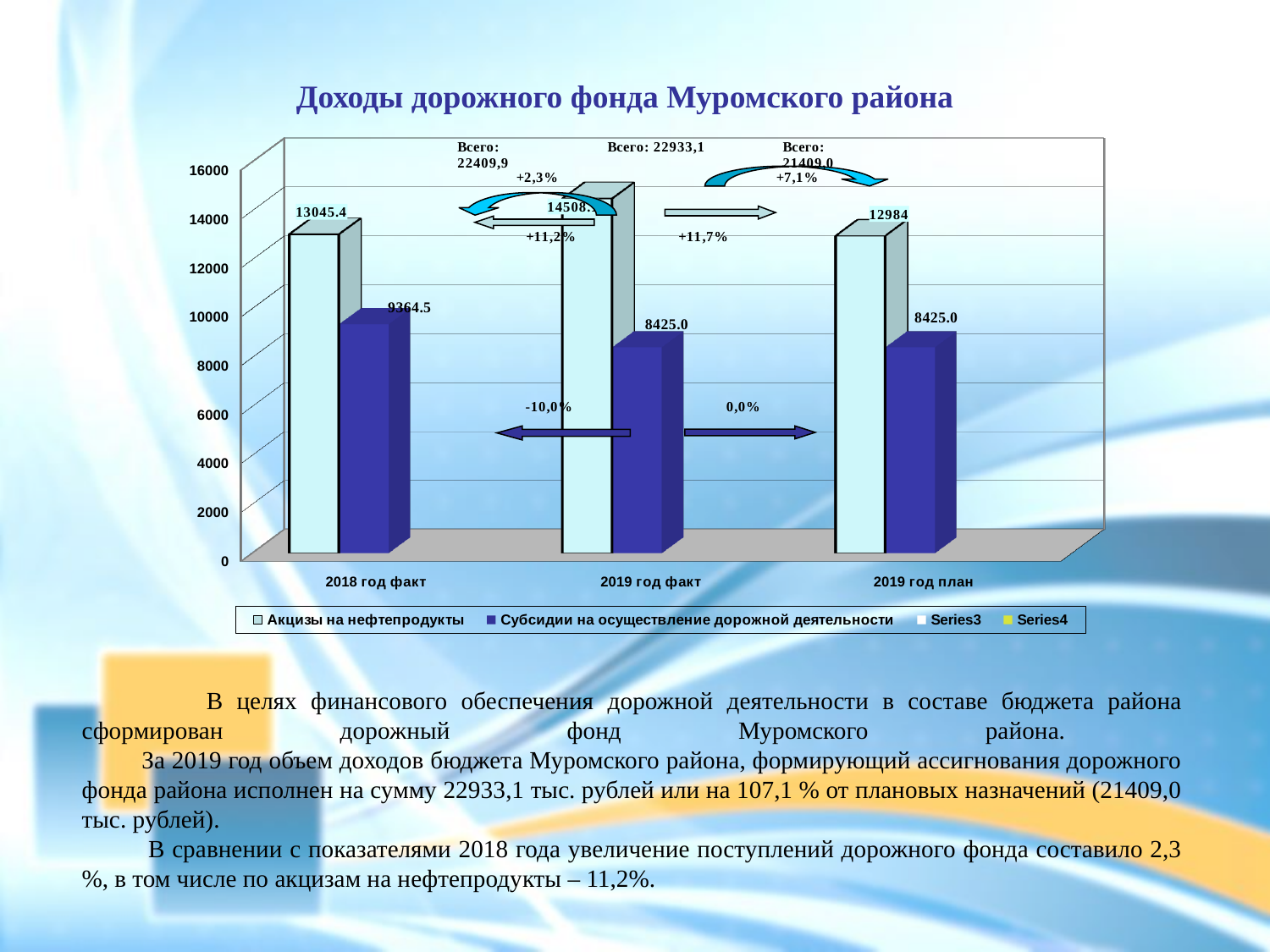
What is the value of Акцизы на нефтепродукты for 2019 год план? 12984 What type of chart is shown on the slide? bar chart What is the value of Акцизы на нефтепродукты for 2018 год факт? 13045.4 Which category has the highest value for Субсидии на осуществление дорожной деятельности? 2018 год факт What is the value of Субсидии на осуществление дорожной деятельности for 2019 год план? 8425.0 Which category has the highest value for Акцизы на нефтепродукты? 2019 год факт Is the value of Акцизы на нефтепродукты for 2019 год факт greater or less than 14000? greater What is the difference between Субсидии на осуществление дорожной деятельности for 2018 год факт and 2019 год факт? 939.5 How many categories are shown on the x axis? 3 What is the value of Субсидии на осуществление дорожной деятельности for 2018 год факт? 9364.5 What total (Всего) is shown above the 2019 год факт bars? 22933,1 How many series does the legend list? 4